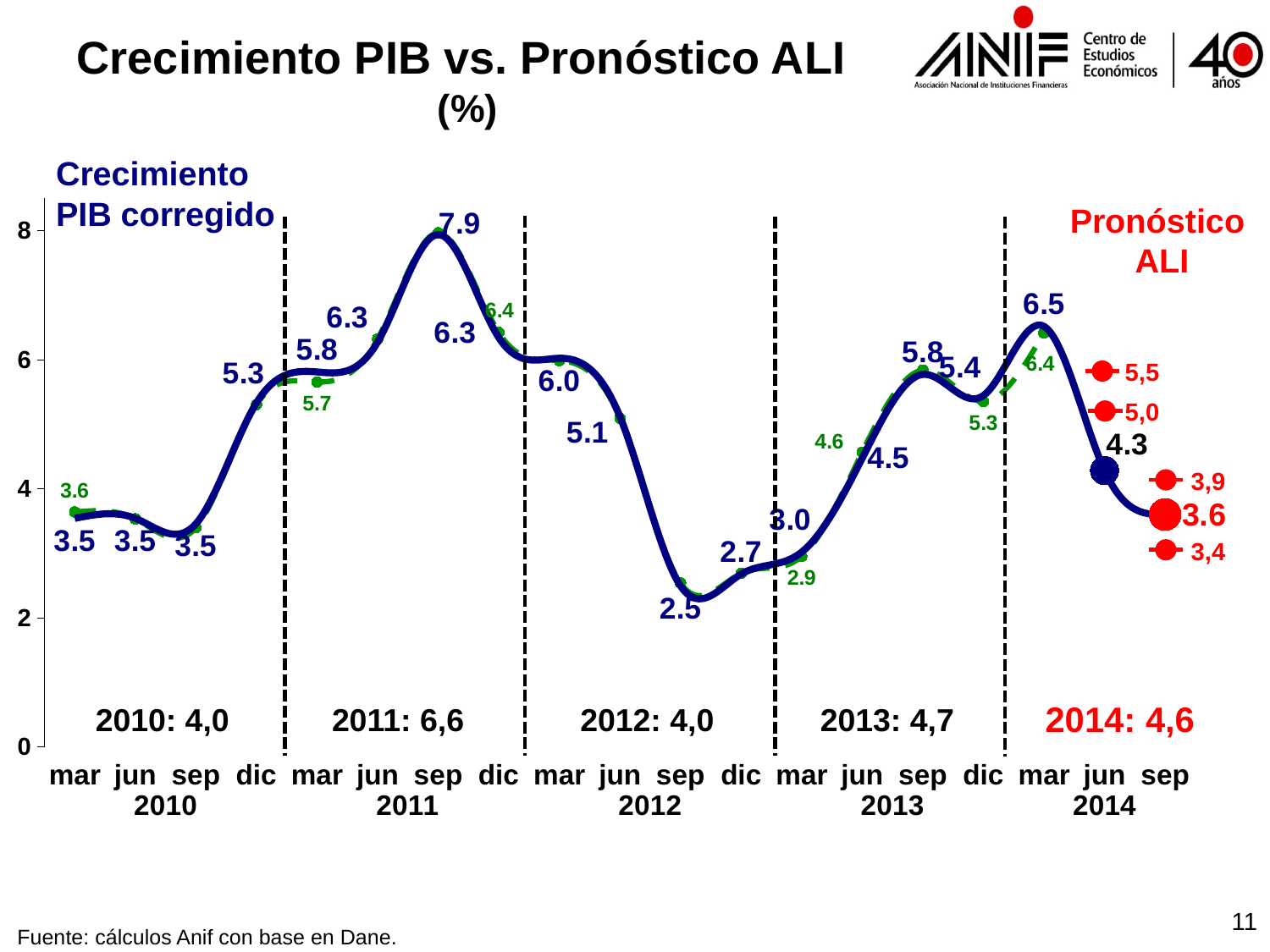
Is the Crecimiento PIB corregido value for sep 2012 greater or less than 4? less What is the Crecimiento PIB corregido value labelled for sep 2011? 7.9 What is the lowest value labelled on the Crecimiento PIB corregido line? 2.5 What is the Crecimiento PIB corregido value labelled for mar 2014? 6.5 What annual growth figure is shown for 2014? 4,6 Does the Crecimiento PIB corregido line rise or fall from mar 2014 to sep 2014? fall What type of chart is shown on the slide? line chart What is the highest value labelled on the Crecimiento PIB corregido line? 7.9 What is the difference between the sep 2011 value (7.9) and the sep 2012 value (2.5) on the Crecimiento PIB corregido line? 5.4 What annual growth figure is shown for 2011? 6,6 What is the highest Pronóstico ALI value shown in red on the right of the chart? 5,5 Which is larger: the annual figure for 2013 or the annual figure for 2012? 2013